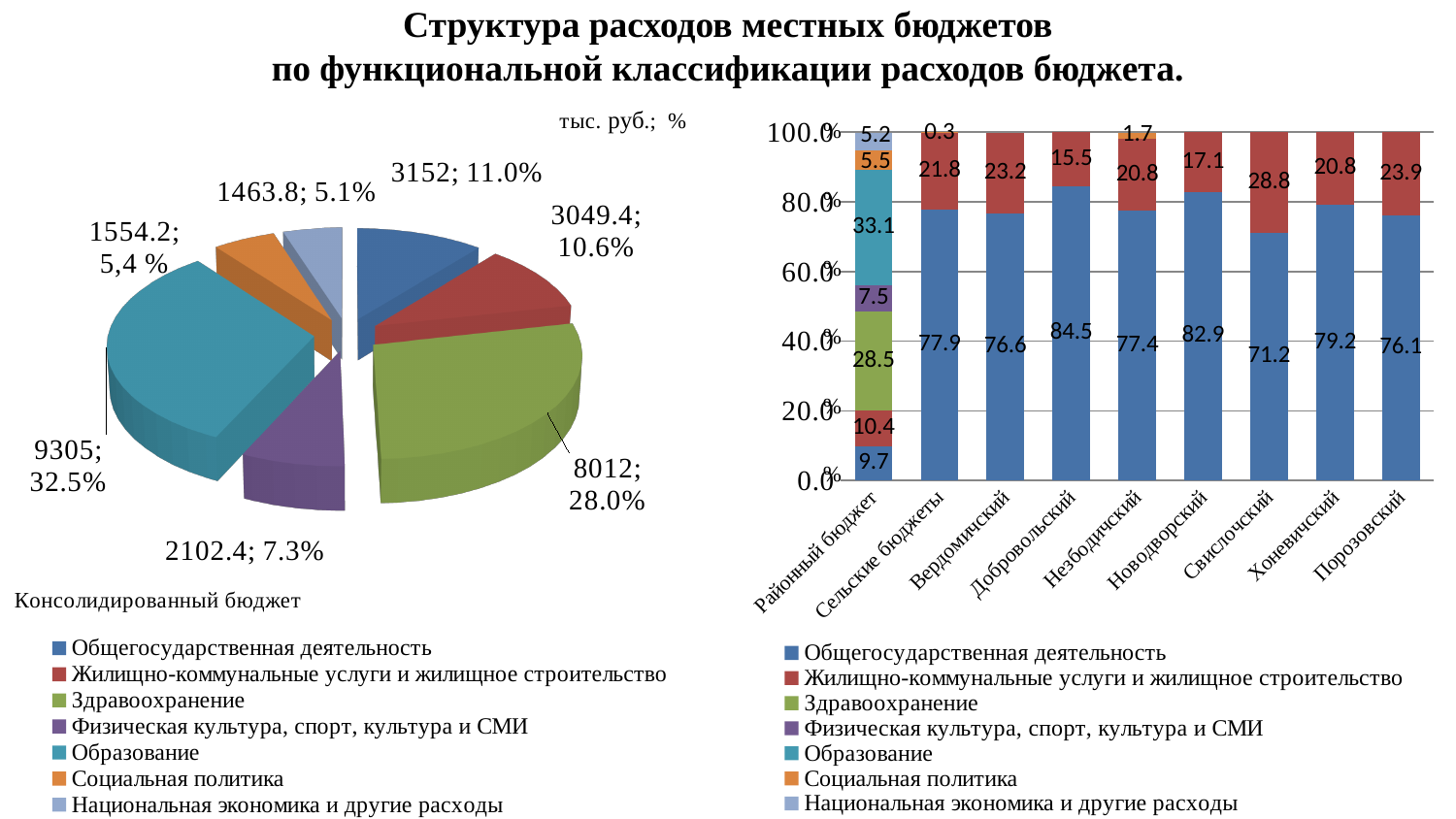
What type of chart is shown on the right side of the slide? Stacked bar chart In the pie chart on the left, what is the share of the Образование slice? 32.5% In the stacked bar chart on the right, which category has the highest value for Общегосударственная деятельность? Добровольский In the stacked bar chart on the right, how many categories are shown on the x axis? 9 In the stacked bar chart on the right, what is the value of Общегосударственная деятельность for Добровольский? 84.5 In the stacked bar chart on the right, what is the value of Образование for Районный бюджет? 33.1 In the stacked bar chart on the right, what is the difference between the Общегосударственная деятельность values for Новодворский and Свислочский? 11.7 In the pie chart on the left, what value in тыс. руб. is shown for Здравоохранение? 8012 In the pie chart on the left, which category has the largest slice? Образование In the stacked bar chart on the right, what is the value of Жилищно-коммунальные услуги и жилищное строительство for Свислочский? 28.8 In the pie chart on the left, which category has the smallest slice? Национальная экономика и другие расходы In the pie chart on the left, how many slices are there? 7